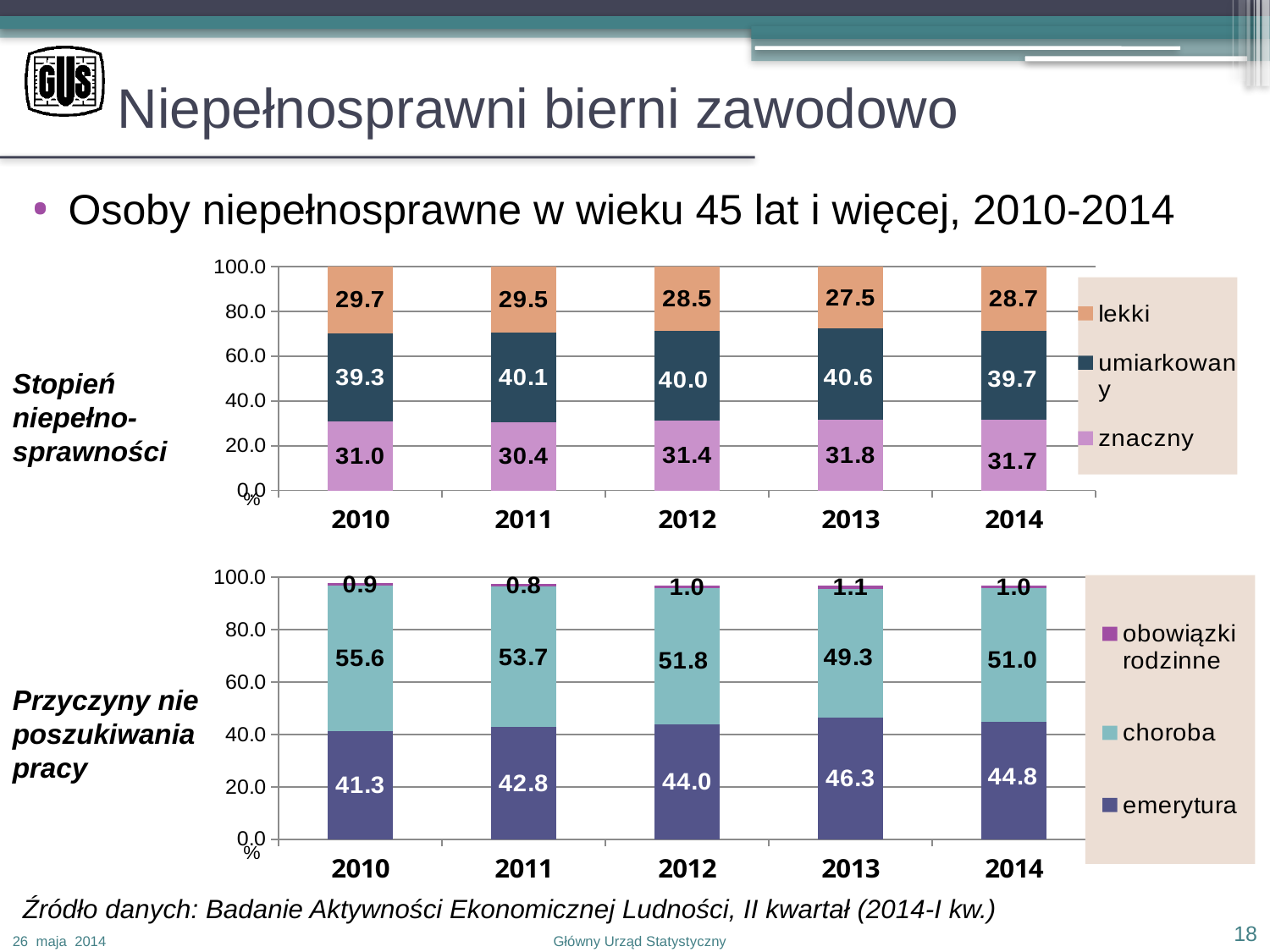
In the bottom chart (Przyczyny nie poszukiwania pracy), what is the total of the three labelled segments for 2012? 96.8 In the bottom chart (Przyczyny nie poszukiwania pracy), is the 'emerytura' value larger in 2010 or in 2014? 2014 In the top chart (Stopień niepełnosprawności), what is the difference between the 'umiarkowany' value and the 'znaczny' value in 2010? 8.3 In the bottom chart (Przyczyny nie poszukiwania pracy), what is the value for 'choroba' in 2011? 53.7 In the top chart (Stopień niepełnosprawności), which year has the highest value for 'umiarkowany'? 2013 In the top chart (Stopień niepełnosprawności), what is the value for 'lekki' in 2013? 27.5 What kind of chart is the bottom chart (Przyczyny nie poszukiwania pracy)? Stacked bar chart In the top chart (Stopień niepełnosprawności), what is the value for 'znaczny' in 2012? 31.4 In the top chart (Stopień niepełnosprawności), how many series does the legend list? 3 In the top chart (Stopień niepełnosprawności), which year has the lowest value for 'lekki'? 2013 In the bottom chart (Przyczyny nie poszukiwania pracy), which year has the highest value for 'choroba'? 2010 In the bottom chart (Przyczyny nie poszukiwania pracy), what is the value for 'emerytura' in 2013? 46.3